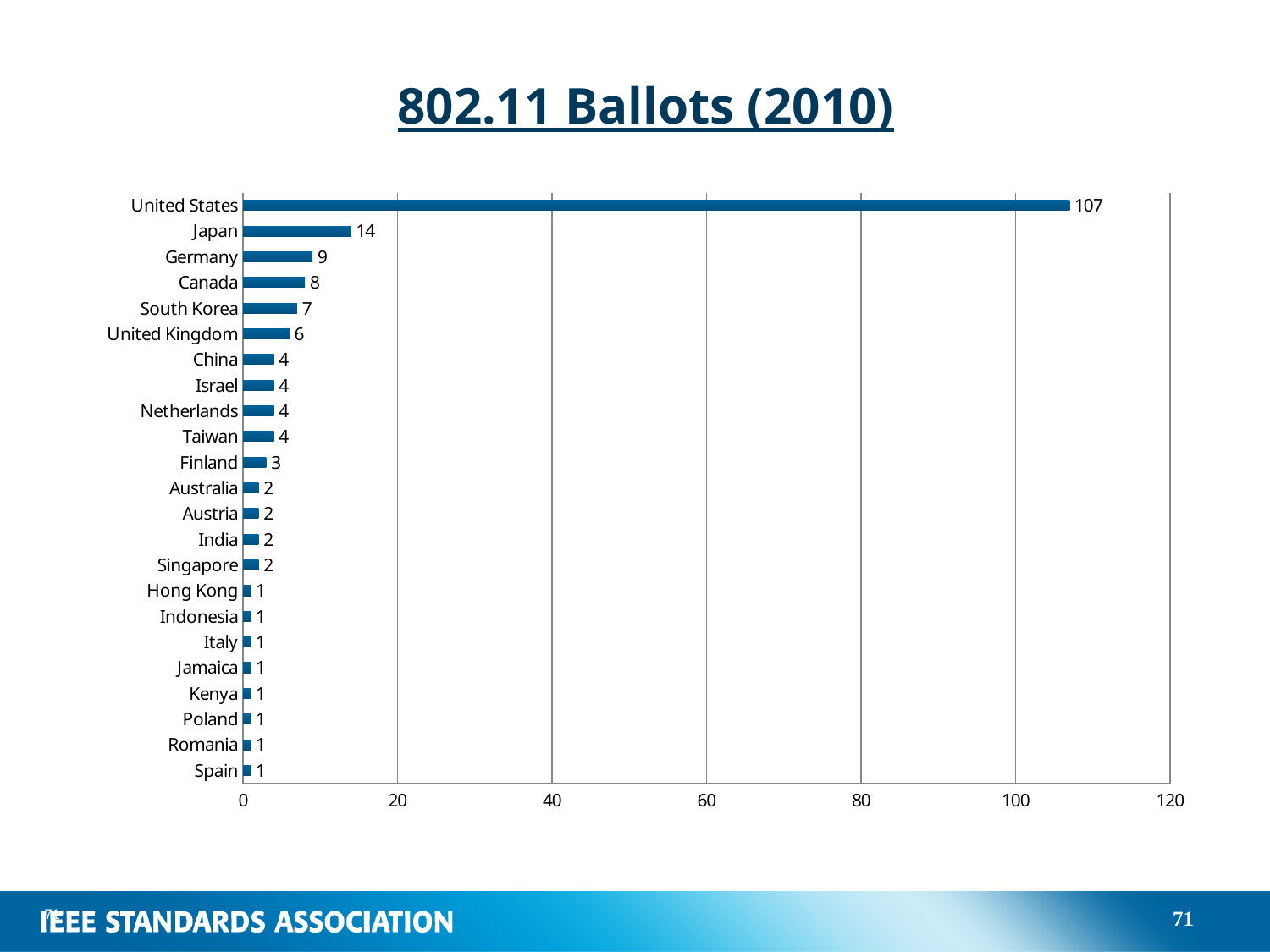
Which country has the highest number of ballots? United States What is the difference between the values for the United States and Japan? 93 How many countries are shown in the chart? 23 What is the value for South Korea? 7 What is the title of the chart? 802.11 Ballots (2010) What kind of chart is shown on the slide? Bar chart What is the value for Japan? 14 What is the value for Finland? 3 What is the value for the United States? 107 Which is larger, the value for the United Kingdom or the value for China? United Kingdom What is the difference between the values for Germany and Canada? 1 Is the value for the United States greater or less than 100? greater